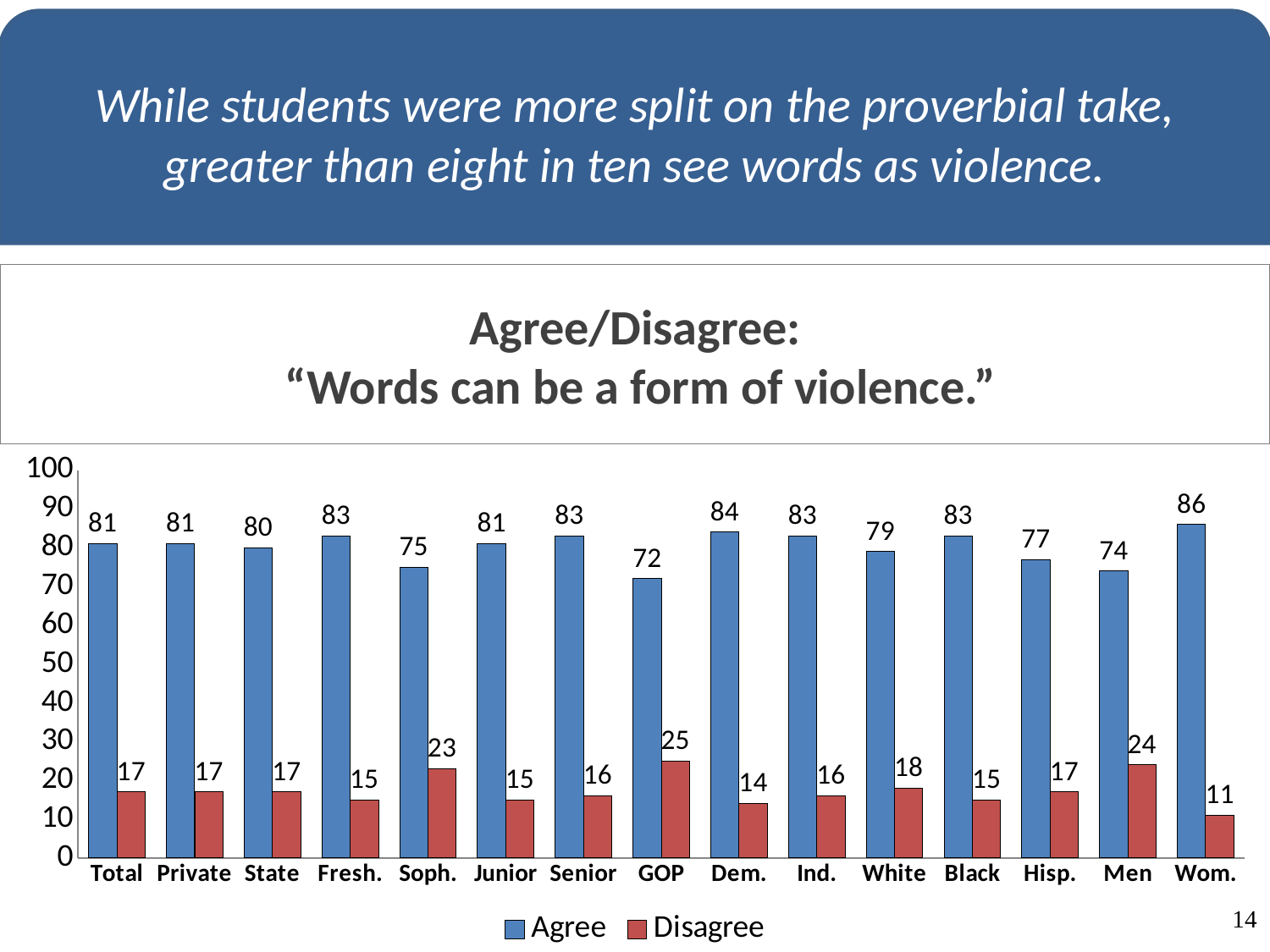
How many series does the legend list? 2 What is the Agree value for GOP? 72 What is the Agree value for Total? 81 Which category has the lowest Agree value? GOP Which category has the highest Agree value? Wom. What colour are the Disagree bars? Red How many categories are shown on the x axis? 15 Which is larger, the Agree value for Soph. or the Agree value for Senior? Senior Which category has the highest Disagree value? GOP What is the difference between the Agree and Disagree values for Men? 50 What is the Disagree value for Wom.? 11 What kind of chart is shown on the slide? Bar chart